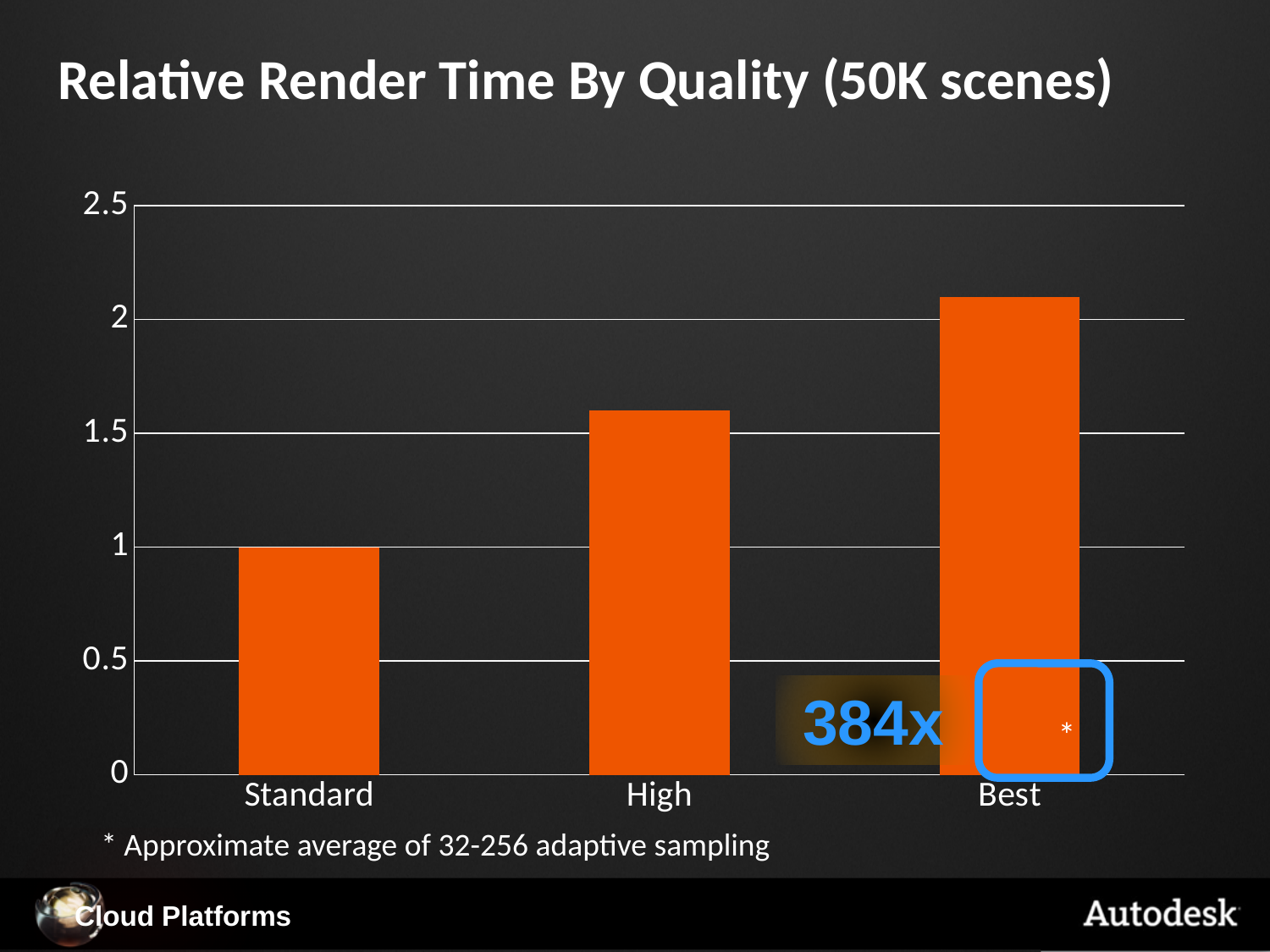
Is the value for Best greater or less than 2? greater What kind of chart is shown on the slide? bar chart Which quality level has the highest relative render time? Best Is the value for High greater or less than 2? less What is the relative render time for Standard? 1 What is the title of the chart? Relative Render Time By Quality (50K scenes) Do the values rise or fall from Standard to Best? rise Is the value for High greater or less than 1.5? greater How many quality levels are shown on the x axis? 3 Which quality level has the lowest relative render time? Standard Which has a larger relative render time, Standard or High? High Which has a larger relative render time, High or Best? Best